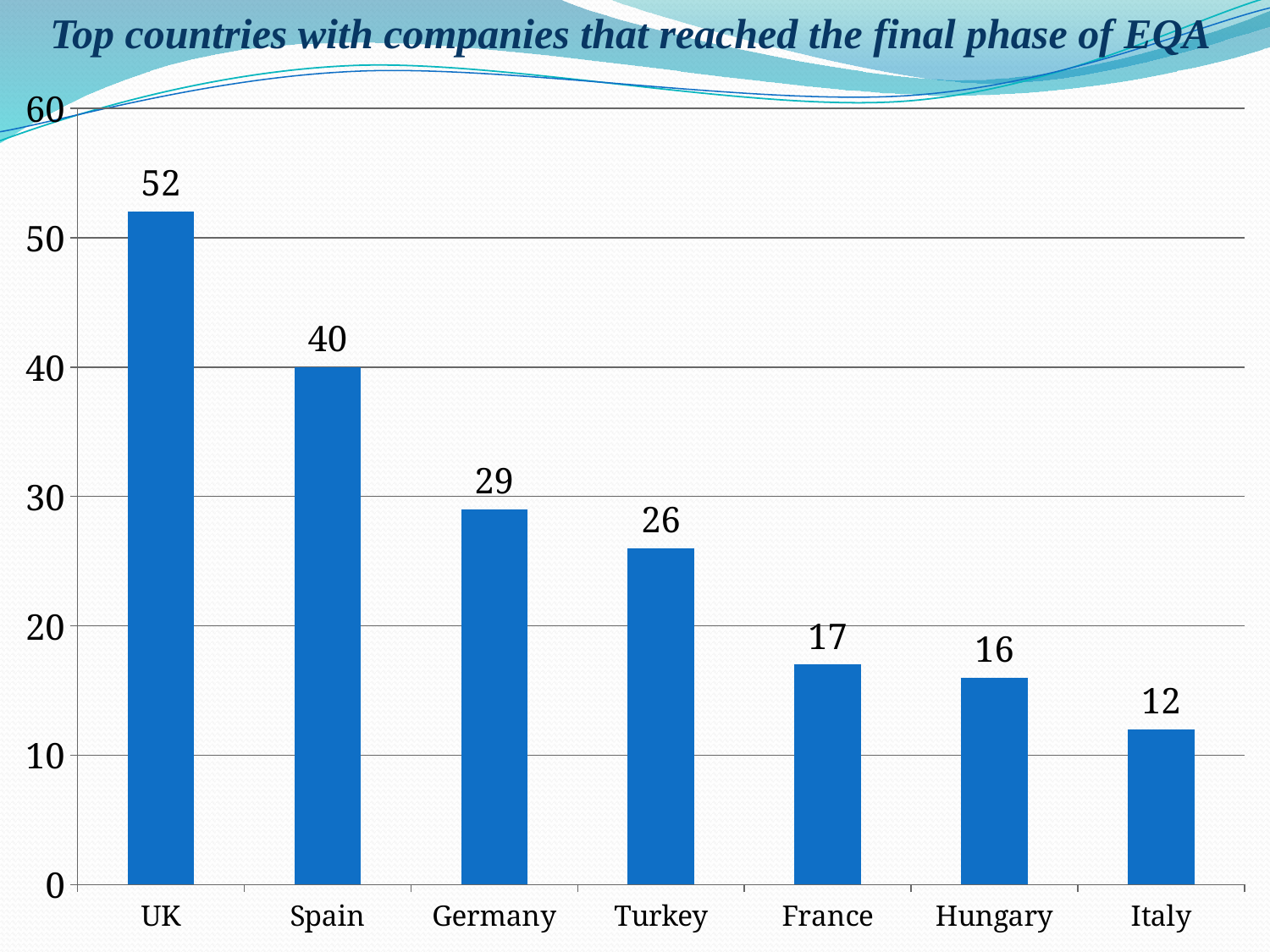
Which is larger, the value for Germany or the value for Turkey? Germany Which country has the lowest value? Italy How many countries are shown on the chart? 7 What is the difference between the values for the UK and Spain? 12 What is the value for Germany? 29 What is the value for Hungary? 16 Which country has the highest value? UK What is the value for the UK? 52 What is the difference between the values for Turkey and France? 9 What kind of chart is shown on the slide? bar chart Do the values rise or fall from left to right across the countries? fall Is the value for Spain greater or less than 30? greater